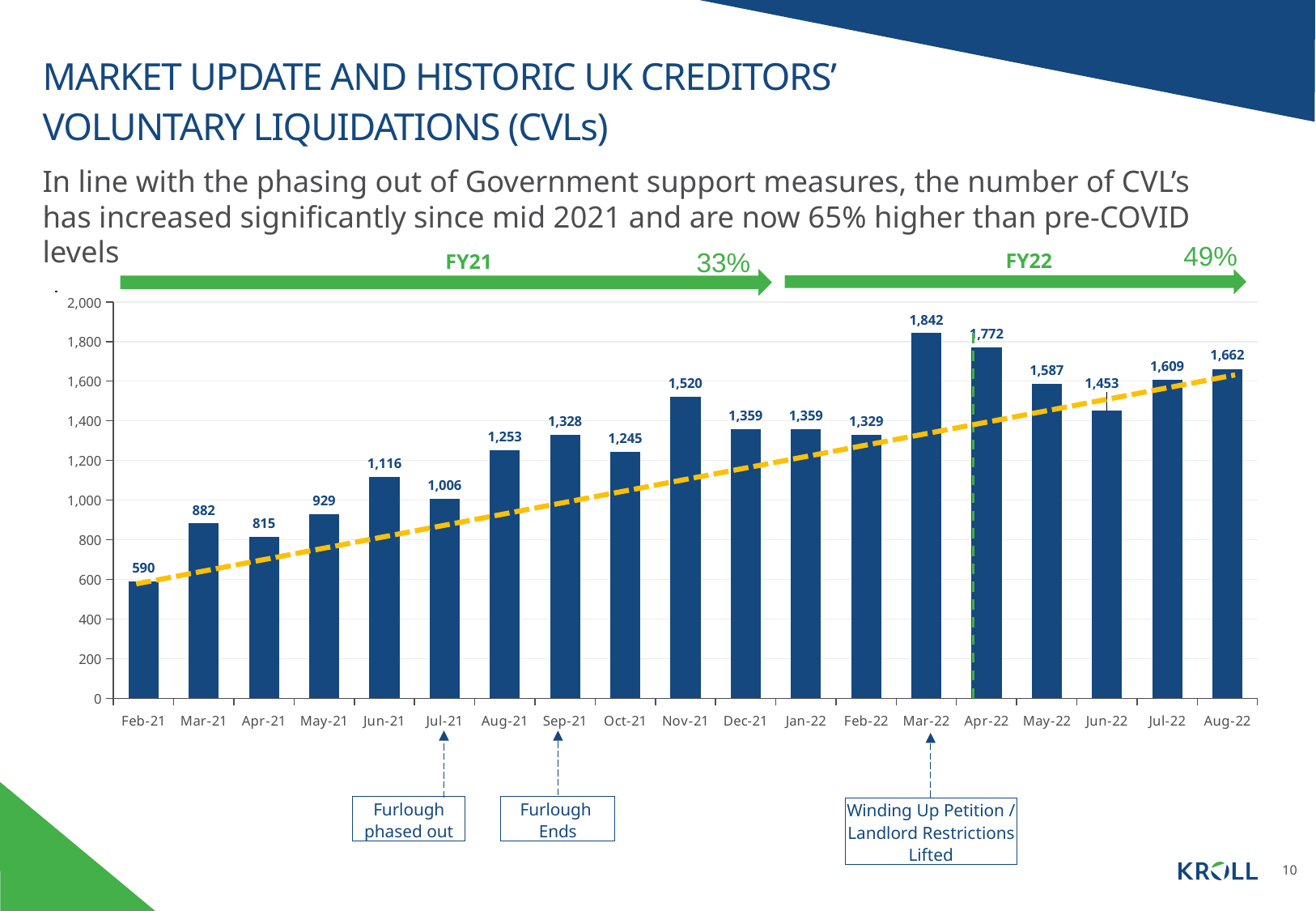
What is the difference between the values for Aug-22 and Feb-21? 1,072 Is the value for Apr-21 greater or less than 1,000? less Which is larger, the value for Jun-22 or the value for Jul-22? Jul-22 What is the value for Nov-21? 1,520 Which month has the highest value? Mar-22 How many months are plotted on the chart? 19 What kind of chart is shown on the slide? bar chart What does the dashed trend line indicate about the values from Feb-21 to Aug-22? rising Which month has the lowest value? Feb-21 What is the difference between the values for Mar-22 and Apr-22? 70 What is the value for Mar-22? 1,842 What is the value for Feb-21? 590